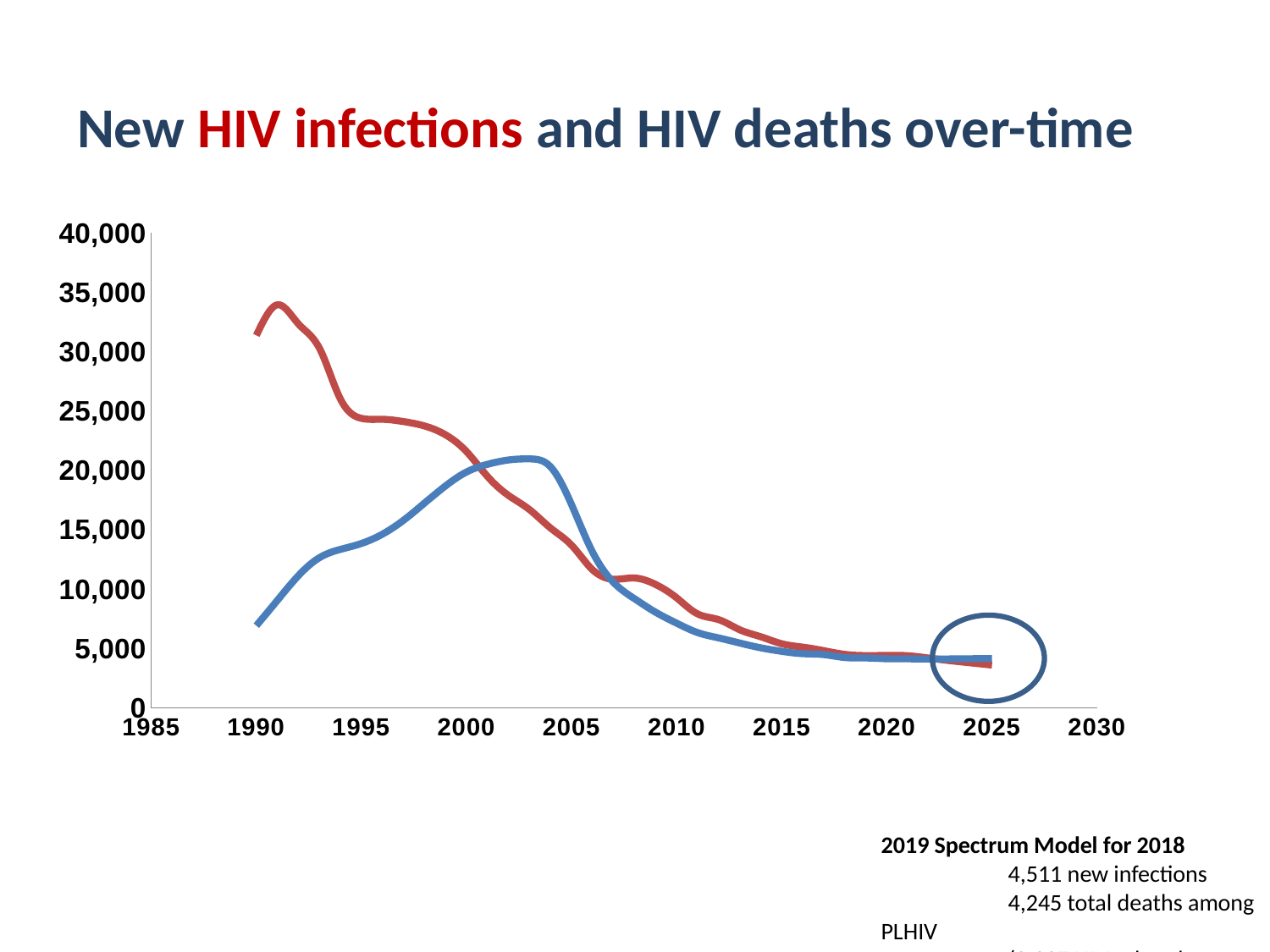
What is the highest value shown on the y axis? 40,000 Is the value of the red line (new HIV infections) in 1990 greater or less than 25,000? greater Does the blue line (HIV deaths) rise or fall between 1990 and 2003? rise Is the value of the red line (new HIV infections) in 2025 greater or less than 5,000? less How many lines are plotted on the chart? 2 Is the peak value of the blue line (HIV deaths) greater or less than 15,000? greater Does the red line (new HIV infections) rise or fall overall from 1990 to 2025? fall In 1995, which line is higher, the red line (new HIV infections) or the blue line (HIV deaths)? red line (new HIV infections) What kind of chart is shown on the slide? line chart Which year on the x axis is circled on the chart? 2025 Around 2003, which line is higher, the red line (new HIV infections) or the blue line (HIV deaths)? blue line (HIV deaths)